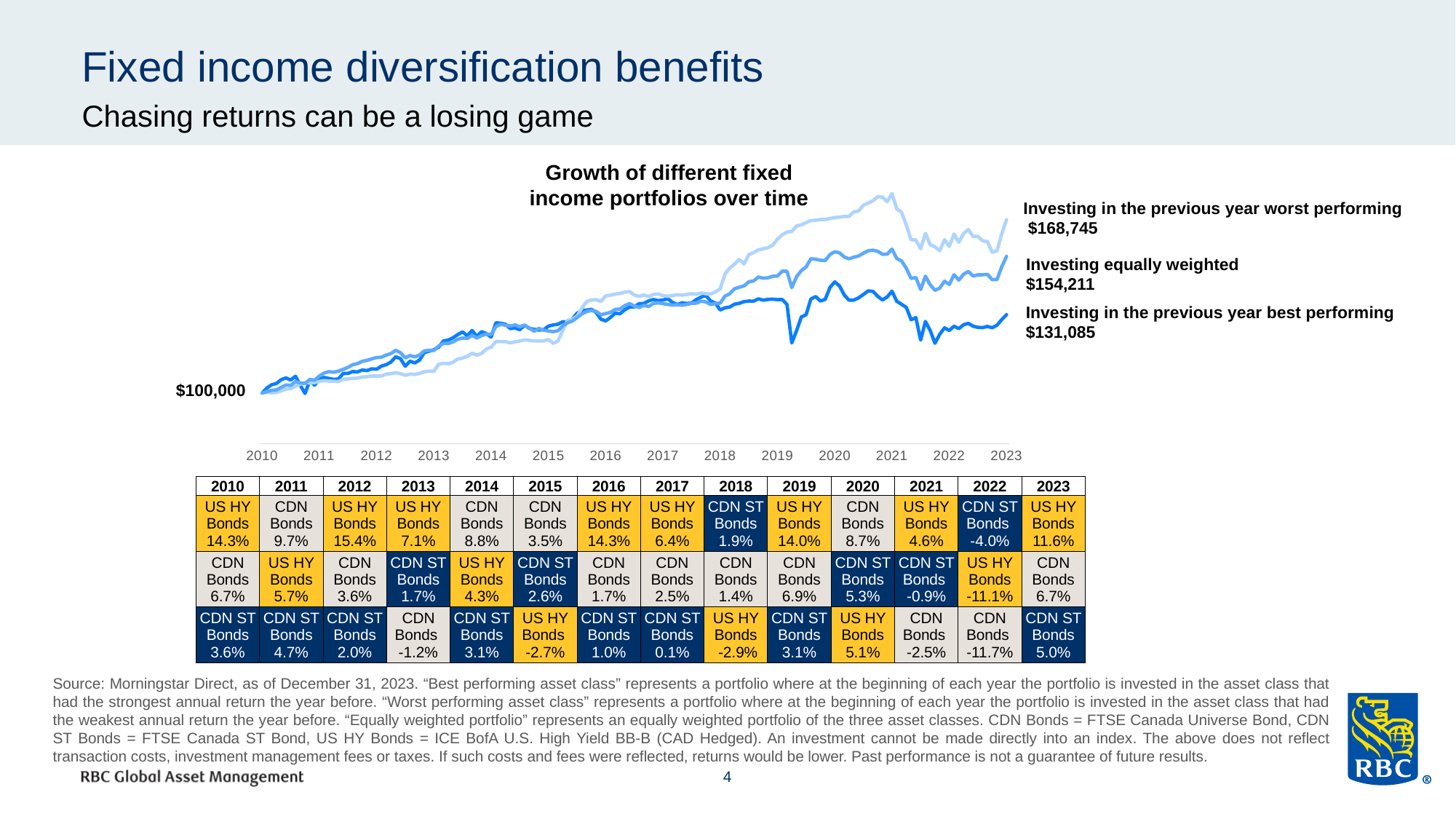
How many years are labelled on the x axis of the chart? 14 Which portfolio has the lowest ending value? Investing in the previous year best performing What is the title of the chart? Growth of different fixed income portfolios over time What is the ending value of the portfolio investing in the previous year best performing asset class? $131,085 What is the ending value of the portfolio investing in the previous year worst performing asset class? $168,745 What kind of chart is shown on the slide? line chart Which ending value is larger: the equally weighted portfolio or the previous year best performing portfolio? Investing equally weighted What is the ending value of the equally weighted portfolio? $154,211 What is the starting value of the portfolios shown on the chart? $100,000 Which portfolio has the highest ending value? Investing in the previous year worst performing How many portfolio series are plotted on the chart? 3 What is the difference between the ending values of the worst-performing strategy and the best-performing strategy portfolios? $37,660